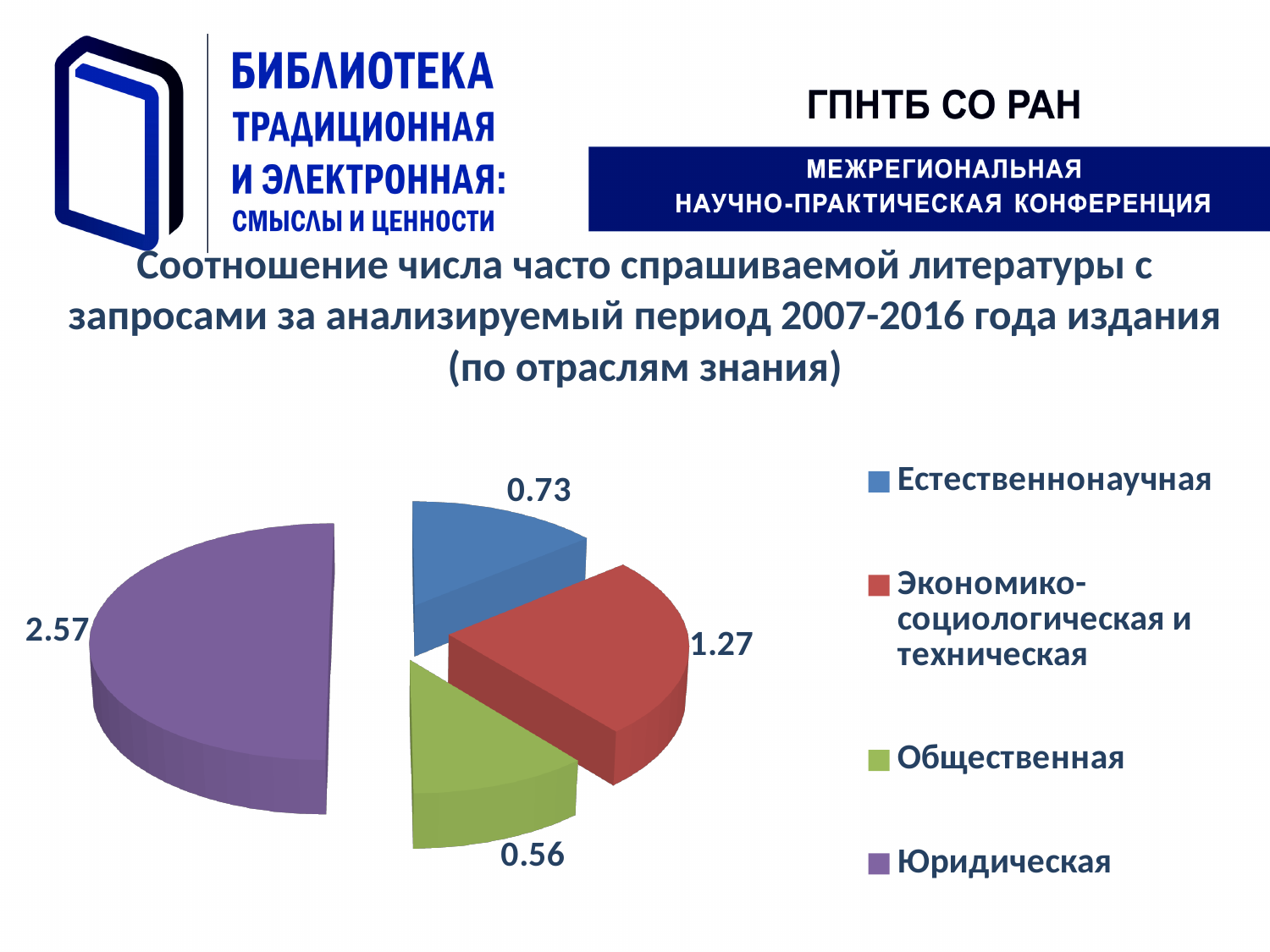
Which category has the largest slice of the pie? Юридическая How many categories does the pie chart have? 4 What kind of chart is shown on the slide? pie chart Which is larger, the value for Естественнонаучная or the value for Экономико-социологическая и техническая? Экономико-социологическая и техническая What is the value for Общественная? 0.56 What is the value for Естественнонаучная? 0.73 What is the value for Юридическая? 2.57 What is the value for Экономико-социологическая и техническая? 1.27 Which category has the smallest slice of the pie? Общественная What is the difference between the values for Юридическая and Экономико-социологическая и техническая? 1.30 What is the difference between the values for Естественнонаучная and Общественная? 0.17 What colour is the slice for Юридическая? purple